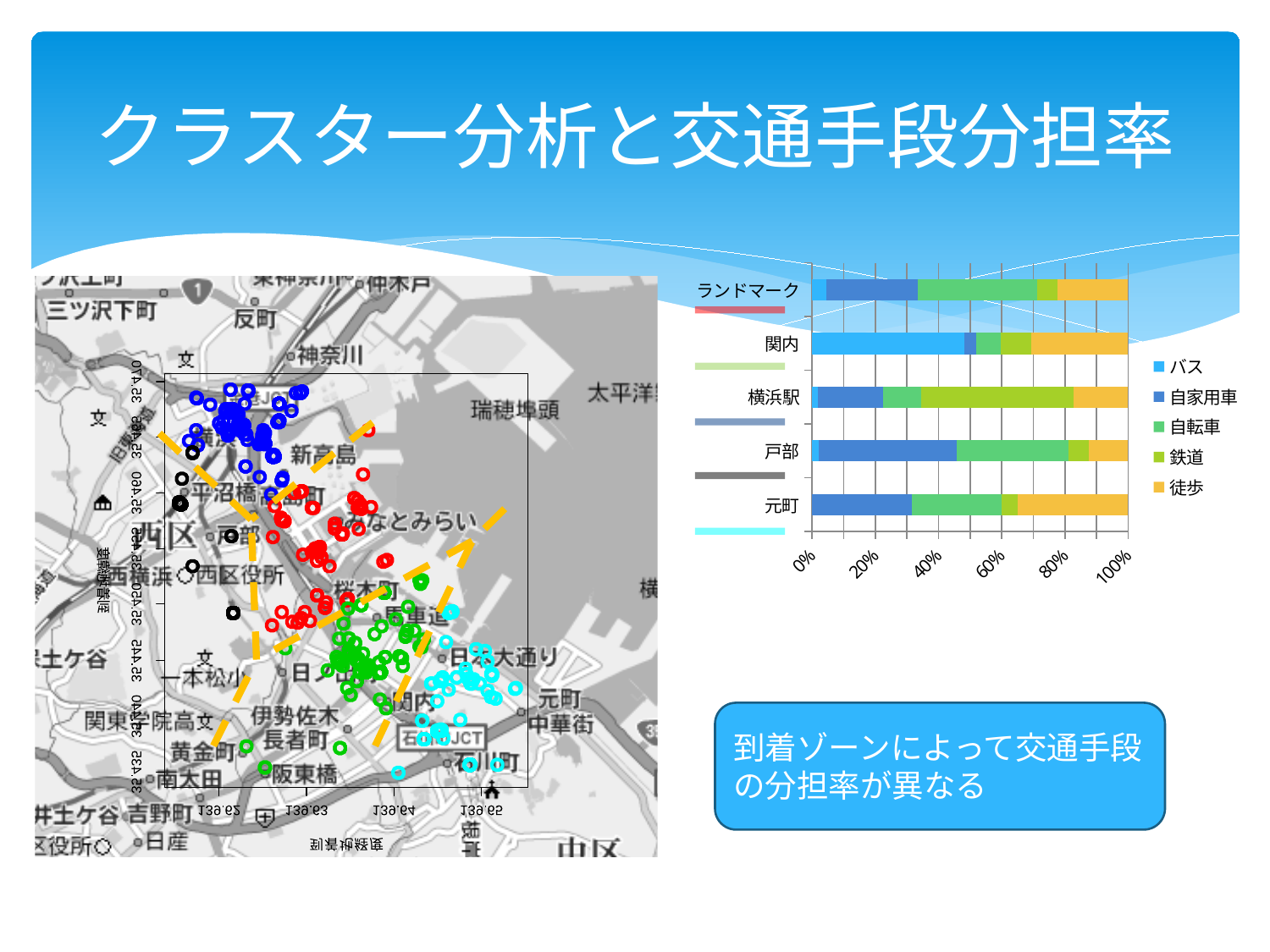
Which has the larger 鉄道 share, 横浜駅 or 関内? 横浜駅 How many categories (arrival zones) are plotted on the bar chart? 5 Which category appears at the top of the bar chart? ランドマーク Which category has the smallest 徒歩 share in the bar chart? 戸部 Is the 自転車 share for 横浜駅 greater or less than 20%? less What kind of chart is shown on the right of the slide? stacked bar chart Which has the larger 自転車 share, 戸部 or 横浜駅? 戸部 Is the 鉄道 share for 横浜駅 greater or less than 40%? greater Which category has the largest 鉄道 share in the bar chart? 横浜駅 How many series does the legend of the bar chart list? 5 Which series are listed in the legend of the bar chart? バス, 自家用車, 自転車, 鉄道, 徒歩 Is the 徒歩 share for 戸部 greater or less than 20%? less